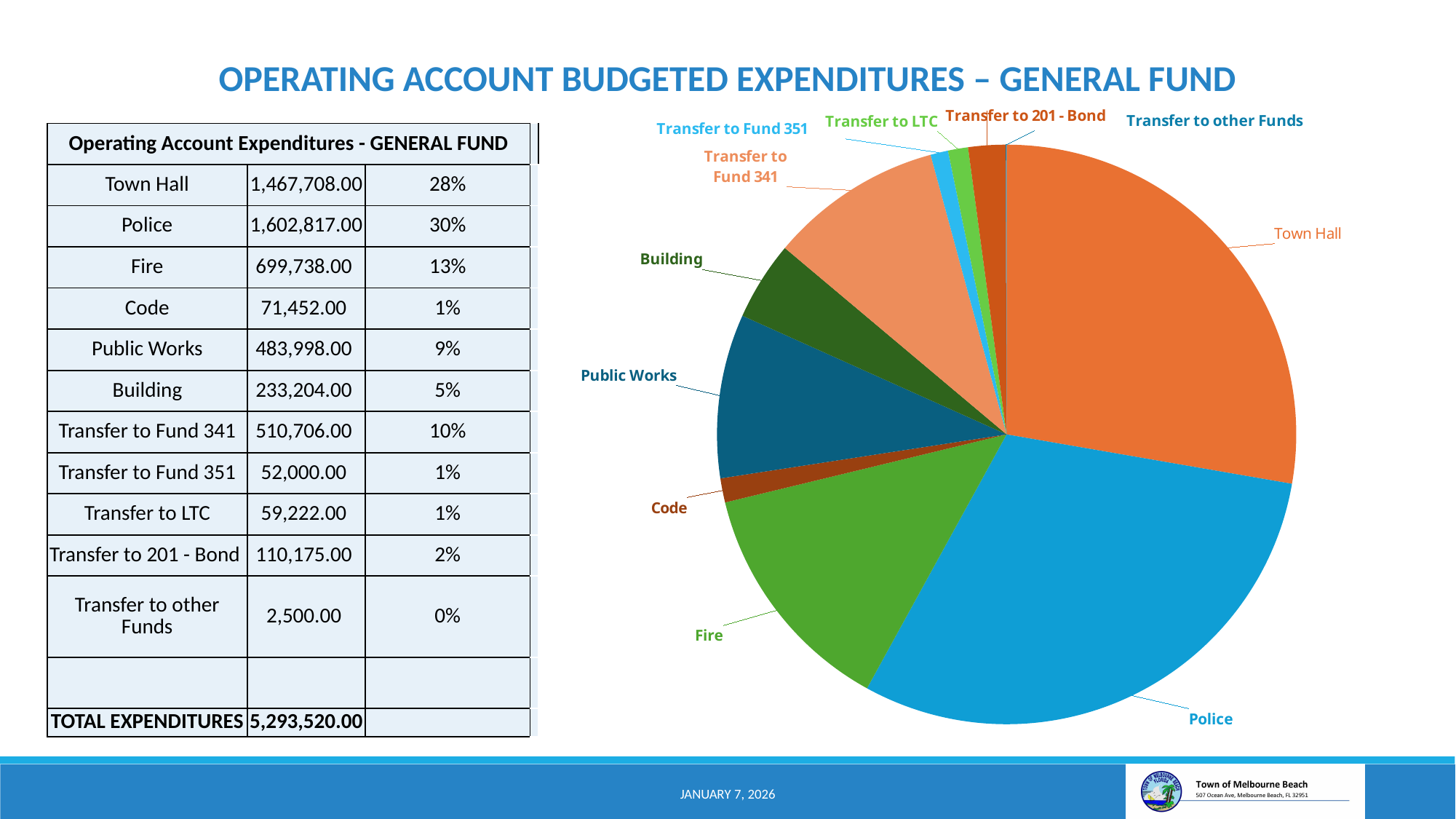
Which slice is larger, Building or Code? Building What kind of chart is shown on the slide? pie chart Which category has the largest slice in the pie chart? Police What is the budgeted expenditure for Police? 1,602,817.00 What share of the pie does Town Hall represent? 28% Which category has the smallest slice in the pie chart? Transfer to other Funds What is the total of all expenditures shown in the pie chart? 5,293,520.00 What share of the pie does Fire represent? 13% What is the difference between the Police and Town Hall expenditures? 135,109.00 What colour is the Police slice in the pie chart? blue How many slices does the pie chart have? 11 Which slice is larger, Fire or Public Works? Fire